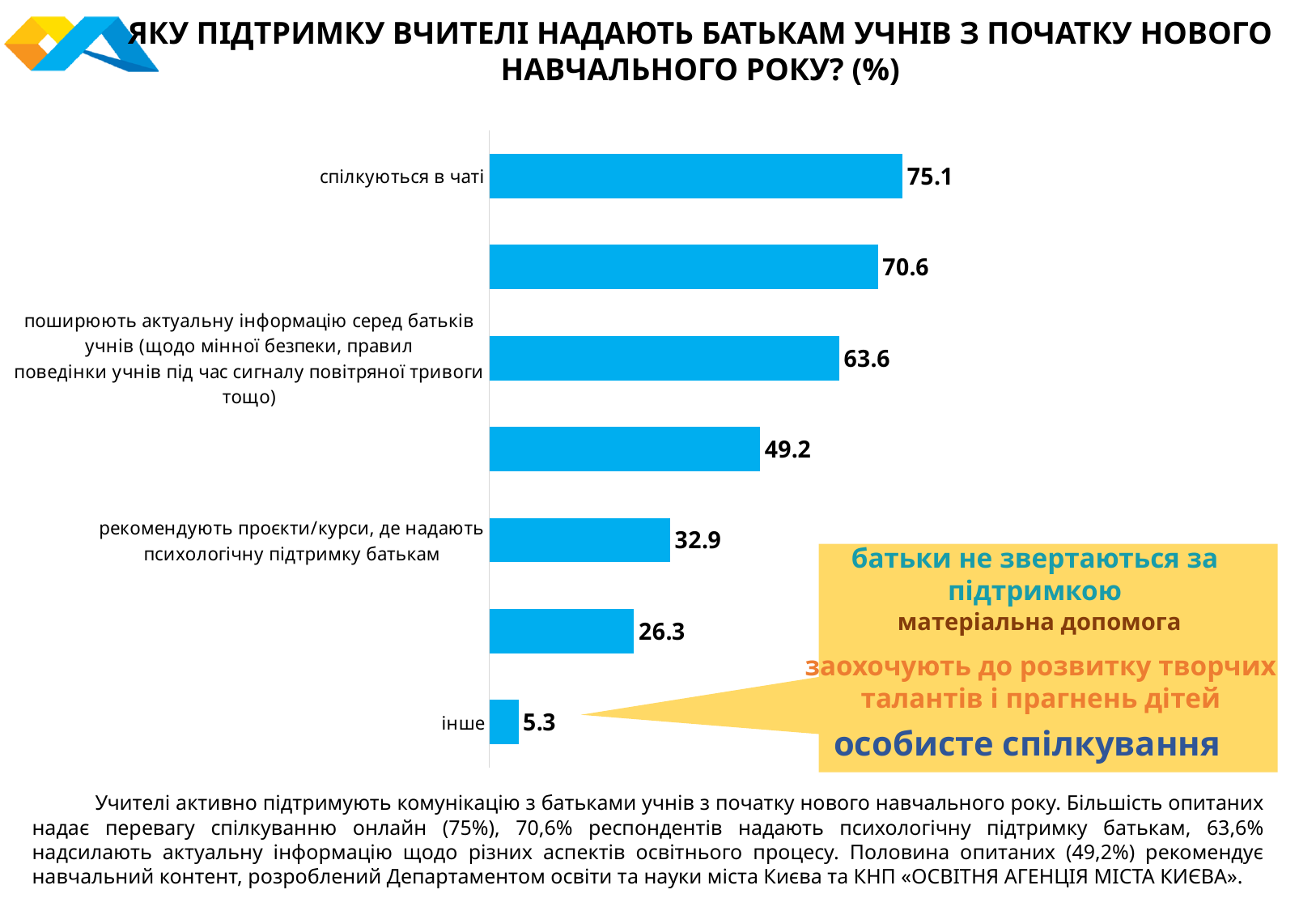
What is the value for "інше"? 5.3 What type of chart is shown on the slide? bar chart Which is larger: the value for "спілкуються в чаті" or the value for "рекомендують проєкти/курси, де надають психологічну підтримку батькам"? спілкуються в чаті What is the largest value shown in the chart? 75.1 What is the difference between the values for "спілкуються в чаті" and "інше"? 69.8 Which category has the lowest value? інше What is the difference between the values for "поширюють актуальну інформацію серед батьків учнів" and "рекомендують проєкти/курси, де надають психологічну підтримку батькам"? 30.7 Which category has the highest value? спілкуються в чаті How many bars are plotted in the chart? 7 What is the value for "рекомендують проєкти/курси, де надають психологічну підтримку батькам"? 32.9 What is the value for "спілкуються в чаті"? 75.1 What is the value for "поширюють актуальну інформацію серед батьків учнів"? 63.6